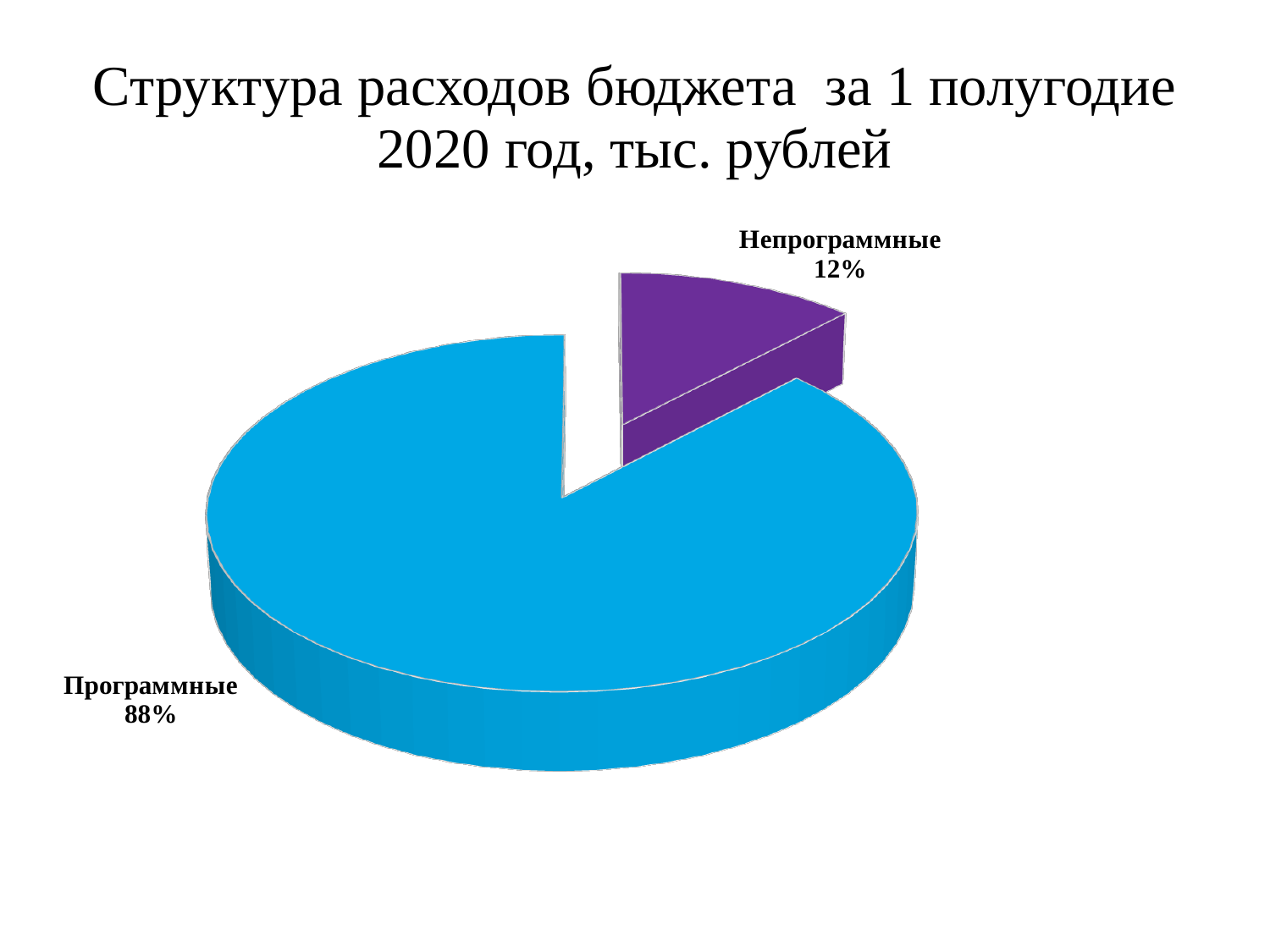
What share of the pie does the Непрограммные slice represent? 12% Which category has the smallest slice of the pie? Непрограммные Which category has the largest slice of the pie? Программные Which is larger, the Программные slice or the Непрограммные slice? Программные What is the title of the slide? Структура расходов бюджета за 1 полугодие 2020 год, тыс. рублей What is the difference in percentage points between the Программные and Непрограммные slices? 76 What colour is the Непрограммные slice? Purple What share of the pie does the Программные slice represent? 88% How many slices does the pie chart have? 2 What kind of chart is shown on the slide? Pie chart